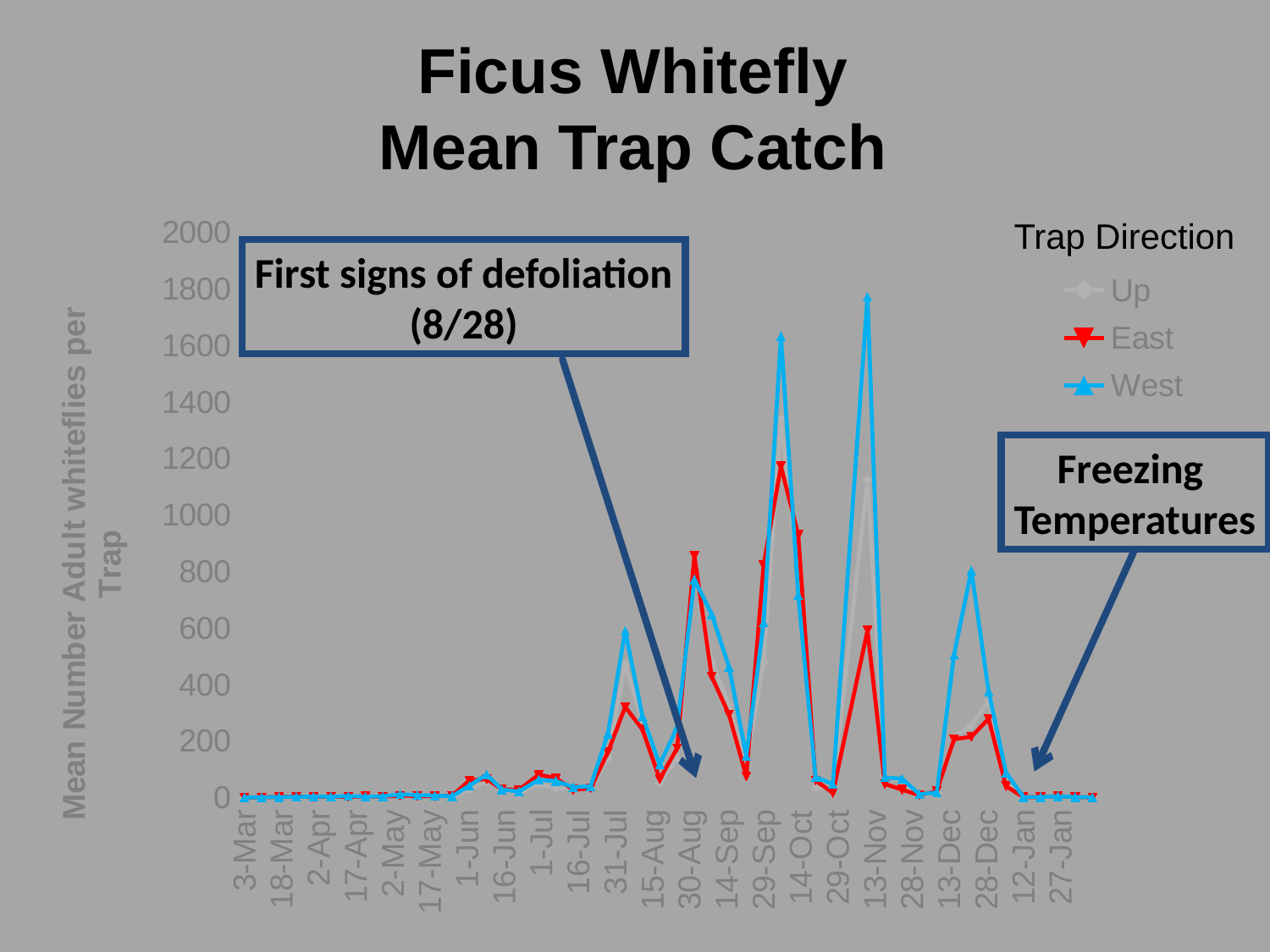
What is the title of the legend? Trap Direction Is the West value at 3-Mar greater or less than 200? less What are the series names listed in the legend? Up, East, West What kind of chart is shown on the slide? line chart Is the East value at 13-Nov greater or less than 800? less At 13-Nov, which series has the larger value, East or West? West How many series does the legend list? 3 Which series reaches the highest peak on the chart? West Is the West value at 13-Nov greater or less than 1600? greater How many date labels are shown on the x axis? 23